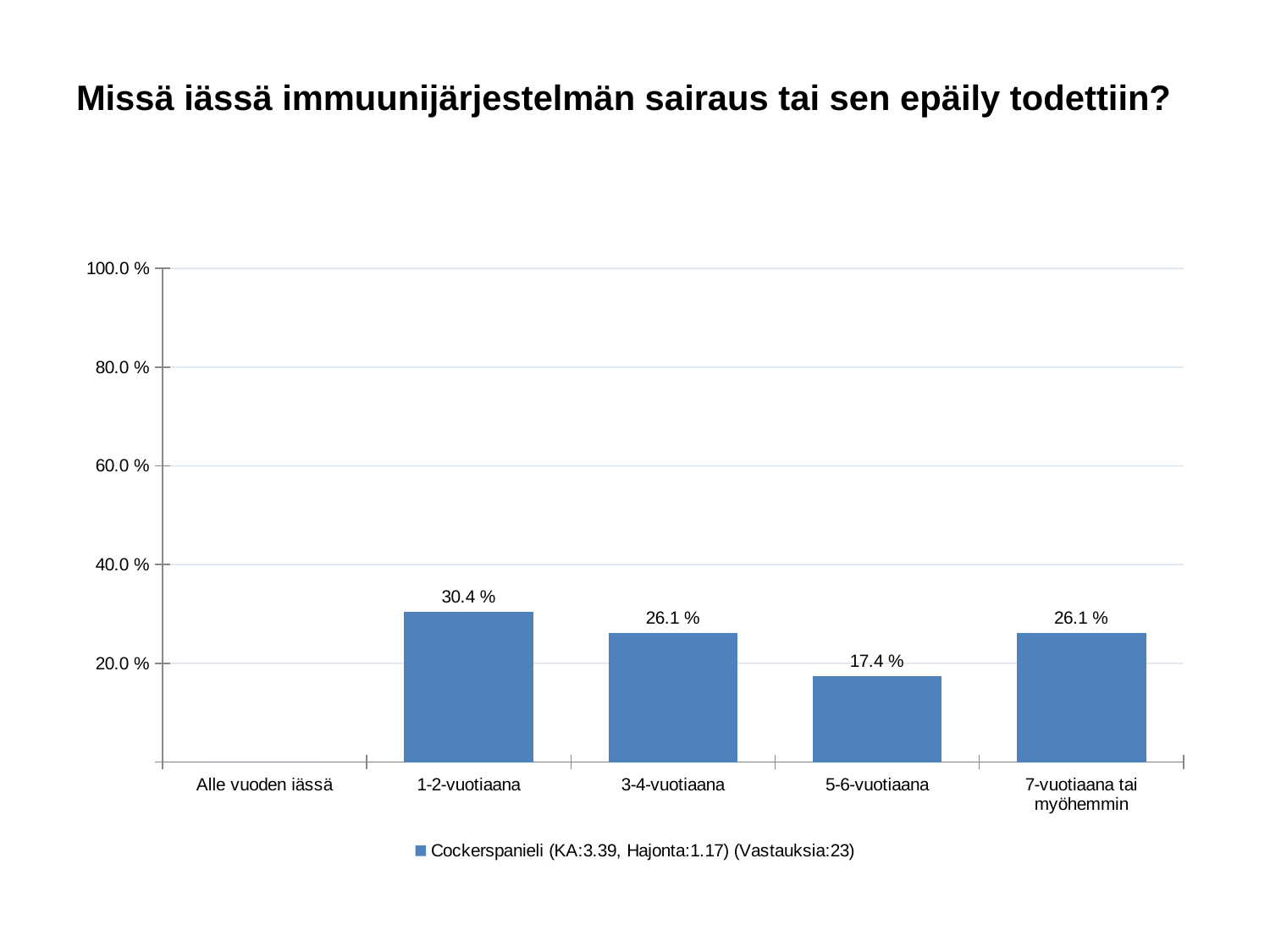
How many age categories are shown on the x axis? 5 Is the value for 5-6-vuotiaana greater or less than 20.0 %? less What kind of chart is shown on the slide? bar chart Which age category has the highest value? 1-2-vuotiaana What is the value for 5-6-vuotiaana? 17.4 % What is the difference between the values for 1-2-vuotiaana and 5-6-vuotiaana? 13.0 % Among the categories with a visible bar, which has the lowest value? 5-6-vuotiaana What is the difference between the values for 3-4-vuotiaana and 5-6-vuotiaana? 8.7 % Which is larger, the value for 1-2-vuotiaana or the value for 3-4-vuotiaana? 1-2-vuotiaana How many series does the legend list? 1 What is the value for 7-vuotiaana tai myöhemmin? 26.1 % What is the value for 1-2-vuotiaana? 30.4 %